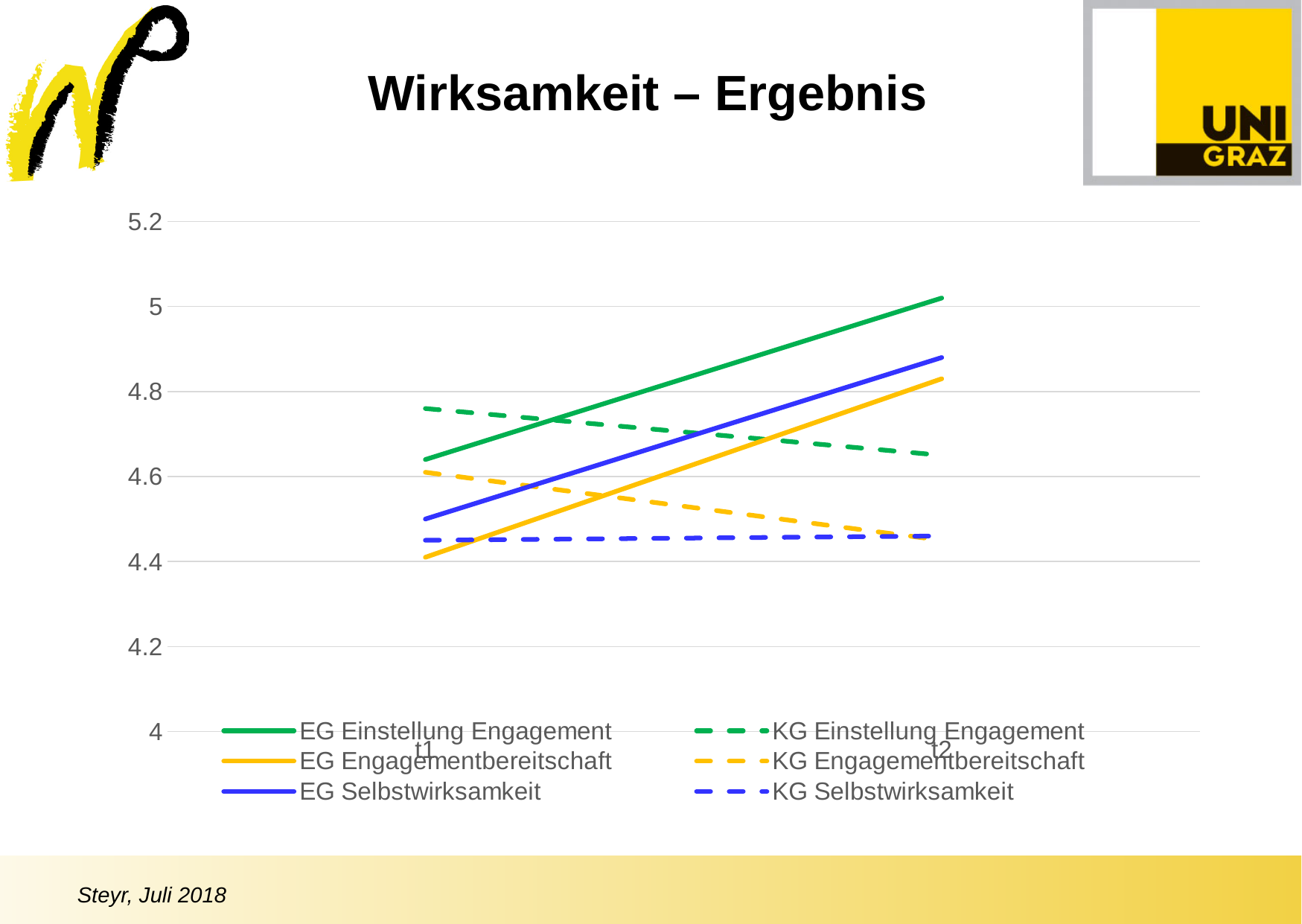
Which series has the highest value at t2? EG Einstellung Engagement Does the KG Einstellung Engagement line rise or fall from t1 to t2? fall Is the value for EG Einstellung Engagement at t2 greater or less than 4.8? greater Is the value for EG Engagementbereitschaft at t1 greater or less than 4.6? less Does the KG Engagementbereitschaft line rise or fall from t1 to t2? fall How many series does the legend list? 6 At t2, which is larger: EG Einstellung Engagement or KG Einstellung Engagement? EG Einstellung Engagement What kind of chart is shown on the slide? line chart Is the value for KG Einstellung Engagement at t1 greater or less than 4.6? greater How many time points are shown on the x axis? 2 What is the title of the slide containing the chart? Wirksamkeit – Ergebnis Does the EG Einstellung Engagement line rise or fall from t1 to t2? rise